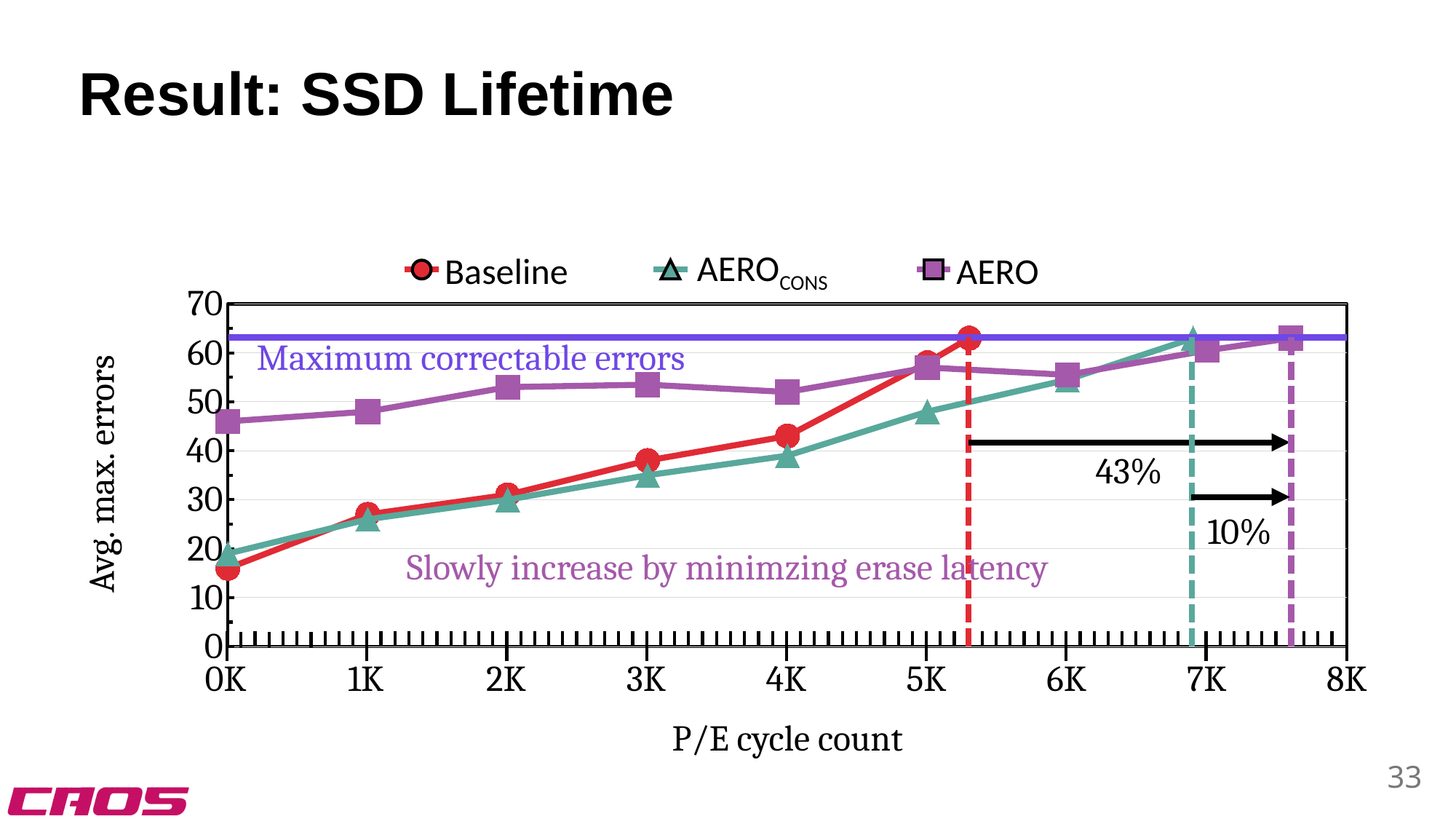
What is the label of the x axis? P/E cycle count Is the value for Baseline at 0K greater or less than 20? less Does the Baseline series rise or fall as the P/E cycle count increases? rise Is the value for AERO at 0K greater or less than 40? greater What is the label of the y axis? Avg. max. errors What kind of chart is shown on the slide? line chart Is the value for AERO at 3K greater or less than 50? greater How many series does the legend list? 3 At 0K P/E cycles, which series has the higher value: AERO or Baseline? AERO Which series has the lowest value at 2K P/E cycles? AERO_CONS At 5K P/E cycles, which series has the higher value: Baseline or AERO_CONS? Baseline